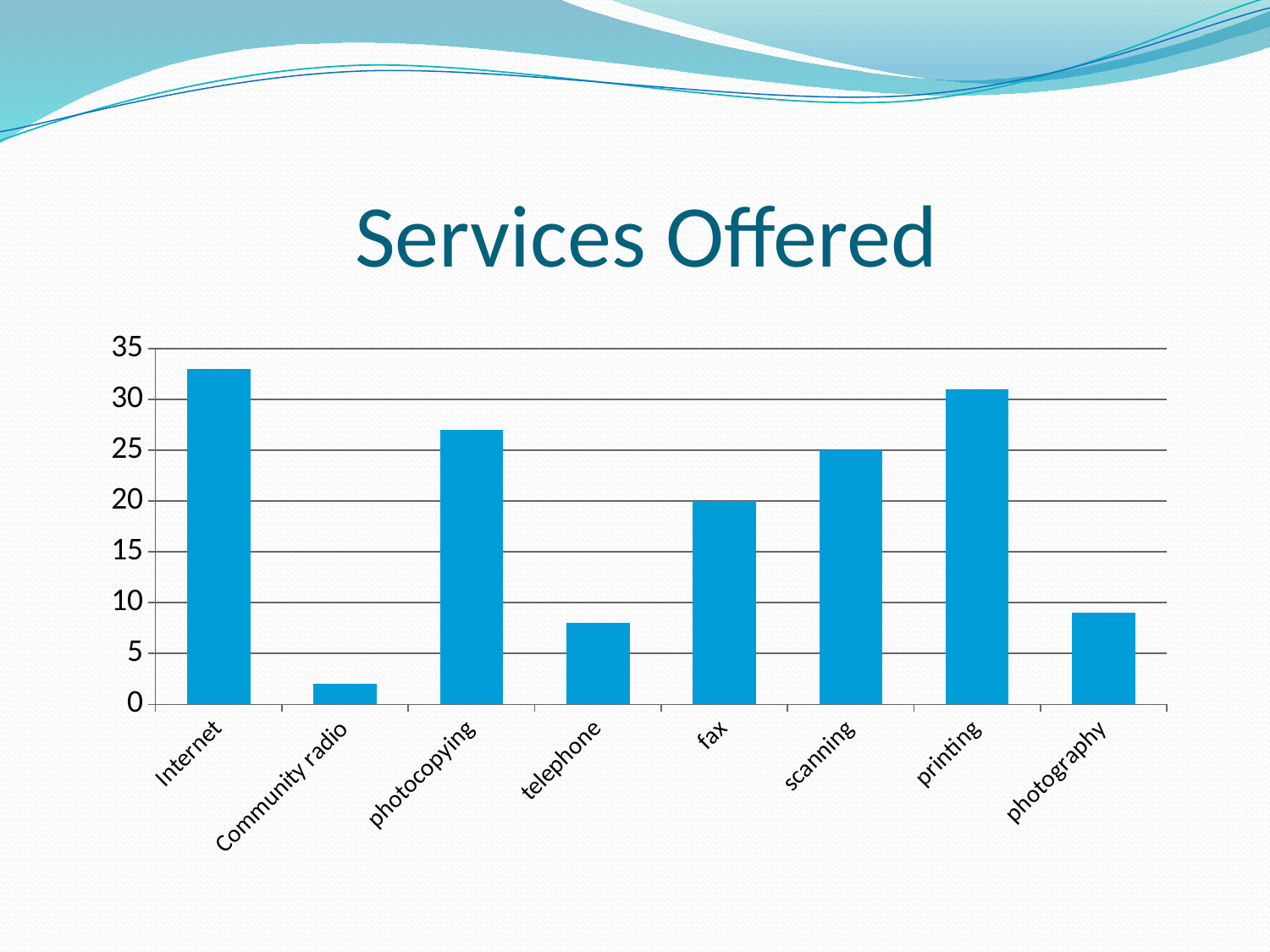
Which service has the lowest bar? Community radio Which is larger, the value for scanning or the value for fax? scanning How many service categories are shown on the x axis? 8 What is the value for scanning? 25 What type of chart is shown on the slide? bar chart Is the value for Internet greater or less than 30? greater What is the value for fax? 20 Which service has the highest bar? Internet Which is larger, the value for printing or the value for photography? printing Is the value for photocopying greater or less than 25? greater What is the title of the chart? Services Offered Is the value for telephone greater or less than 10? less